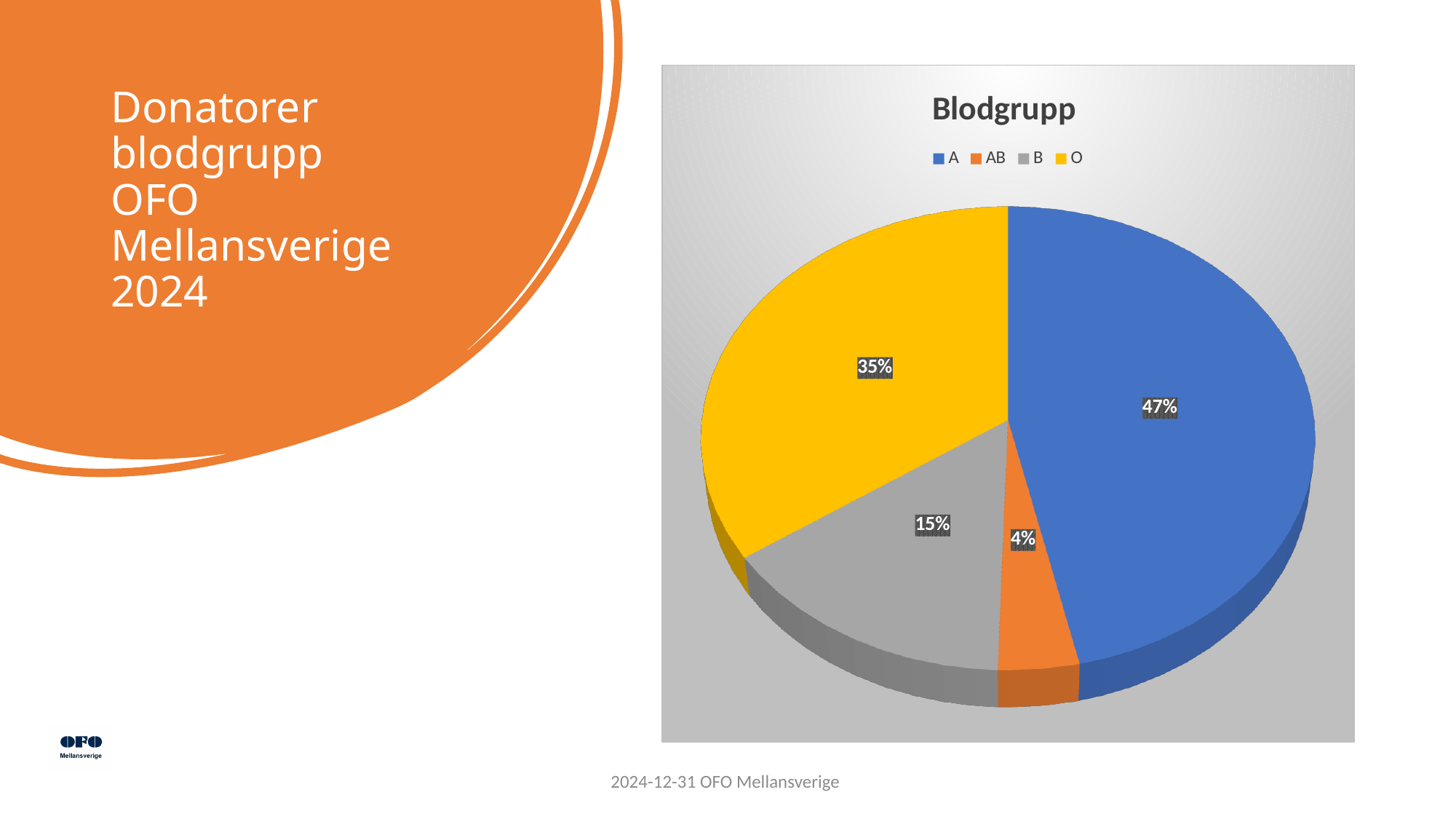
What share of the pie does blood group O have? 35% What kind of chart is shown on the slide? Pie chart What share of the pie does blood group AB have? 4% What is the difference in percentage points between the shares of blood group A and blood group O? 12 Which blood group has the smallest share of the pie? AB Which colour represents blood group O in the chart? Yellow Which blood group has the largest share of the pie? A What share of the pie does blood group A have? 47% What share of the pie does blood group B have? 15% What is the title of the chart? Blodgrupp Which has a larger share, blood group B or blood group O? O How many blood groups are shown in the pie chart? 4